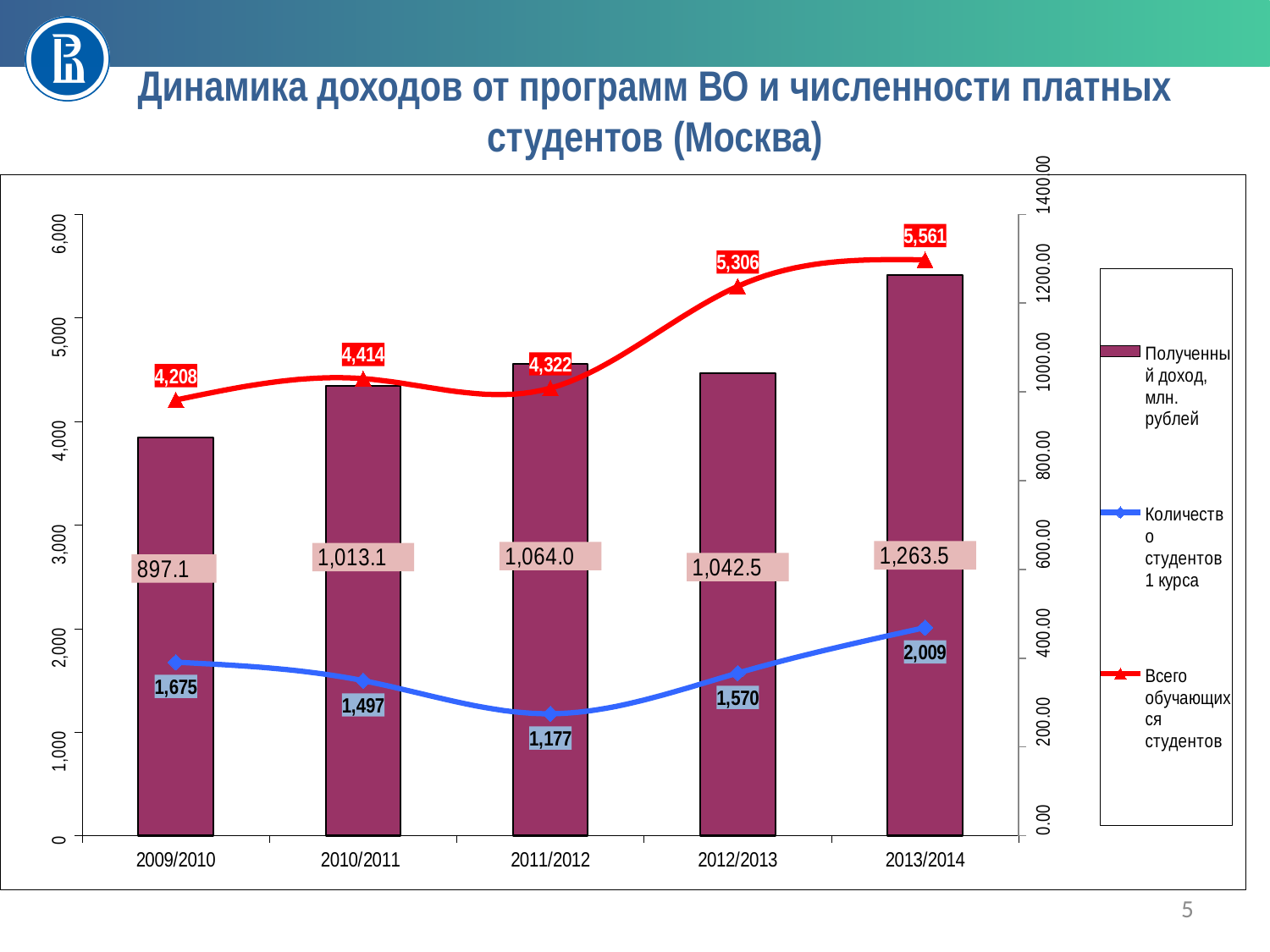
Does "Всего обучающихся студентов" rise or fall from 2012/2013 to 2013/2014? rise How many academic years are shown on the x axis? 5 In which academic year is "Количество студентов 1 курса" the highest? 2013/2014 What is the value of "Количество студентов 1 курса" for 2011/2012? 1,177 What kind of chart is used for the "Полученный доход, млн. рублей" series? bar chart In which academic year is "Полученный доход, млн. рублей" the lowest? 2009/2010 Which is larger: "Полученный доход, млн. рублей" in 2011/2012 or in 2012/2013? 2011/2012 What is the difference between the "Всего обучающихся студентов" values for 2013/2014 and 2009/2010? 1,353 What is the value of "Всего обучающихся студентов" for 2012/2013? 5,306 What is the value of "Полученный доход, млн. рублей" for 2013/2014? 1,263.5 How many series does the legend list? 3 What colour is the line for "Всего обучающихся студентов"? red